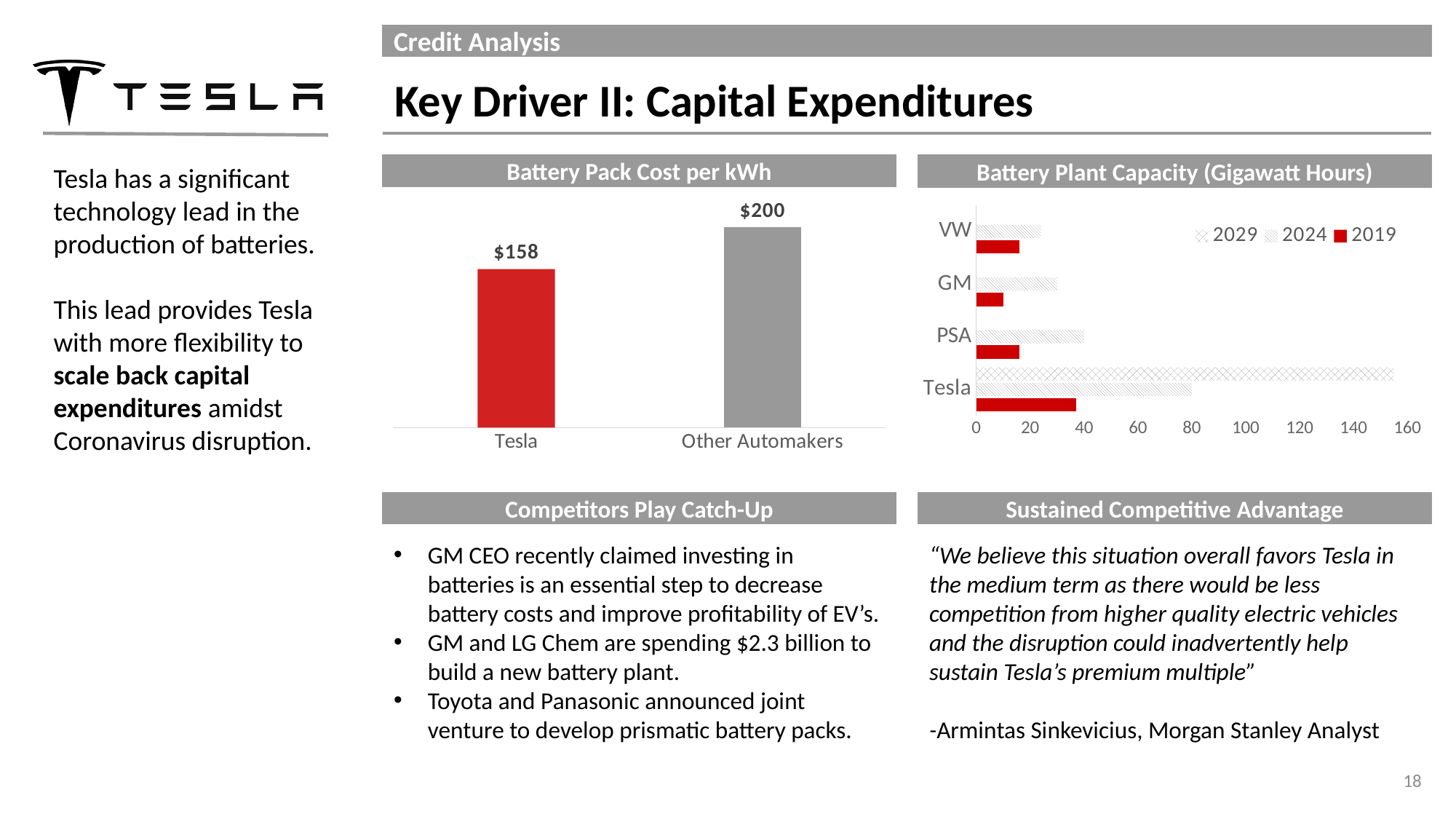
In the Battery Plant Capacity (Gigawatt Hours) chart, which series is shown in red? 2019 How many series does the legend of the Battery Plant Capacity (Gigawatt Hours) chart list? 3 In the Battery Plant Capacity (Gigawatt Hours) chart, is the 2019 value for GM greater or less than 20? less In the Battery Pack Cost per kWh chart, what is the value for Other Automakers? $200 In the Battery Plant Capacity (Gigawatt Hours) chart, which company has the highest 2029 capacity? Tesla What kind of chart is the Battery Pack Cost per kWh chart? Bar chart In the Battery Plant Capacity (Gigawatt Hours) chart, is the 2029 value for Tesla greater or less than 140? greater In the Battery Pack Cost per kWh chart, which category has the lower cost? Tesla How many categories are shown in the Battery Plant Capacity (Gigawatt Hours) chart? 4 In the Battery Pack Cost per kWh chart, what is the difference between Other Automakers and Tesla? $42 In the Battery Plant Capacity (Gigawatt Hours) chart, which company has the lowest 2019 capacity? GM In the Battery Pack Cost per kWh chart, what is the value for Tesla? $158